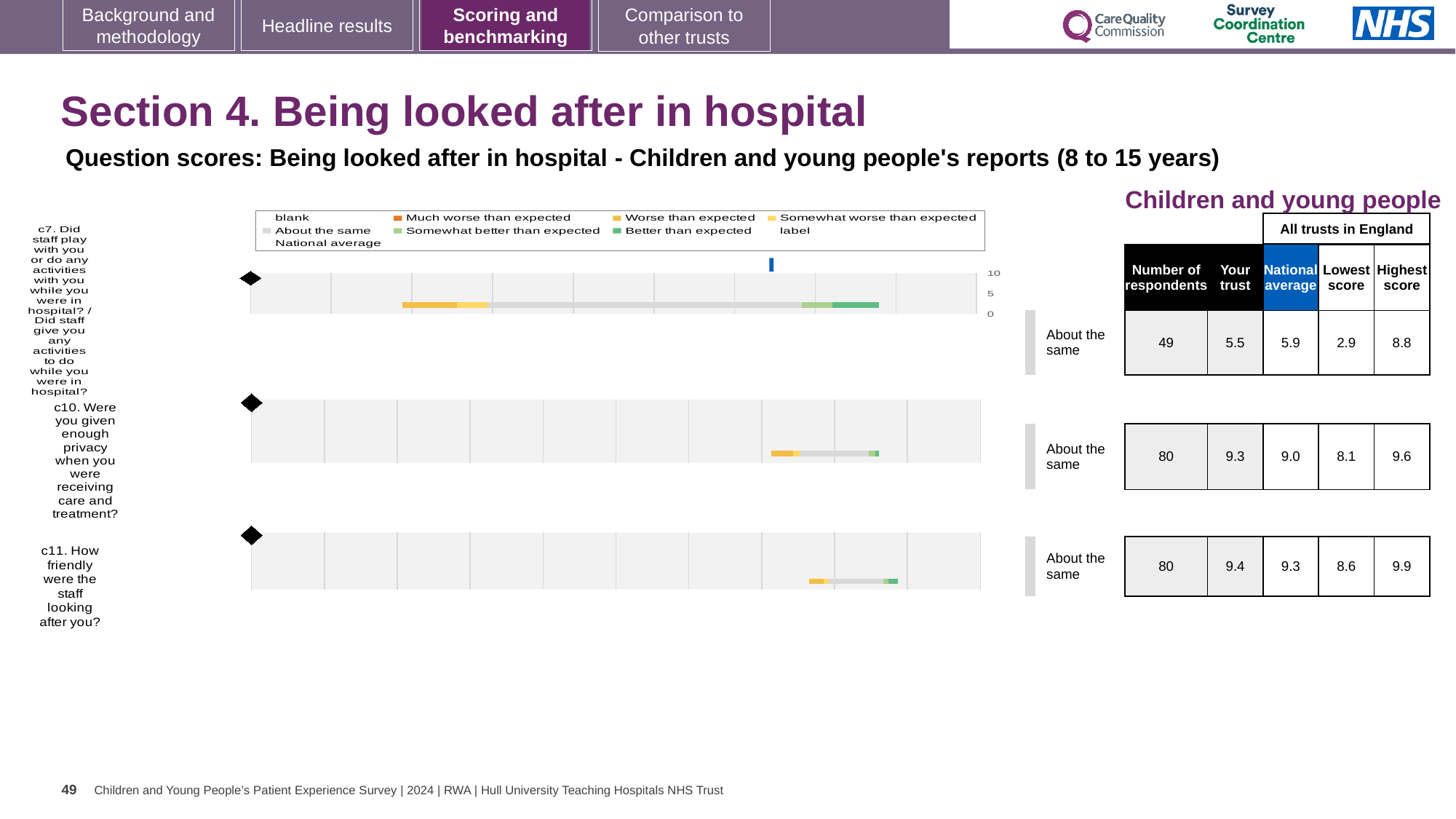
What is the highest score across all trusts in England for question c11? 9.9 What kind of chart is used to show the question scores on this slide? Bar chart Which question has the lowest national average score on this slide? c7. Did staff play with you or do any activities with you while you were in hospital? How many questions are plotted on this slide? 3 How many respondents answered question c11 (How friendly were the staff looking after you?)? 80 For question c10, which is larger: the 'Your trust' score or the national average? Your trust For question c7, what is the difference between the highest score and the lowest score across all trusts in England? 5.9 Which question has the highest 'Your trust' score on this slide? c11. How friendly were the staff looking after you? For question c11, how much higher is the 'Your trust' score than the national average? 0.1 What is the national average score for question c7 (Did staff play with you or do any activities with you while you were in hospital?)? 5.9 What is the 'Your trust' score for question c10 (Were you given enough privacy when you were receiving care and treatment?)? 9.3 What benchmark category is shown for question c7? About the same